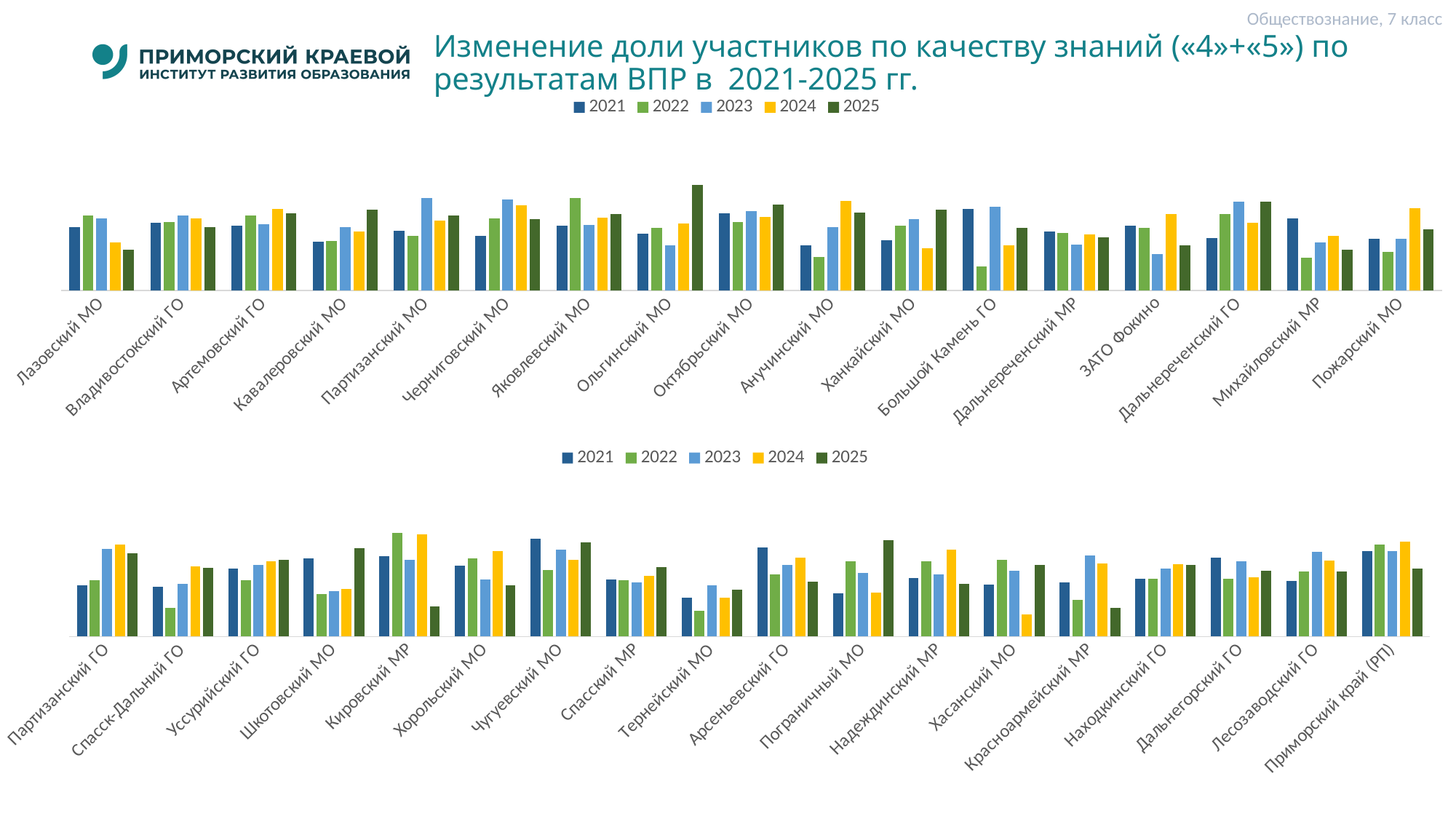
In the bottom chart, which year has the lowest bar for Хасанский МО? 2024 In the top chart, which year has the lowest bar for Большой Камень ГО? 2022 What kind of chart is the top chart on the slide? bar chart In the bottom chart, which year has the lowest bar for Кировский МР? 2025 In the top chart, which year has the highest bar for Анучинский МО? 2024 In the bottom chart, which year has the highest bar for Пограничный МО? 2025 In the top chart, which year has the highest bar for Ольгинский МО? 2025 Which colour represents the 2024 series in the legend of the charts? yellow In the top chart, which is larger for Большой Камень ГО: the 2021 value or the 2022 value? 2021 How many categories are shown on the x axis of the top chart? 17 How many series does the legend of the top chart list? 5 How many categories are shown on the x axis of the bottom chart? 18